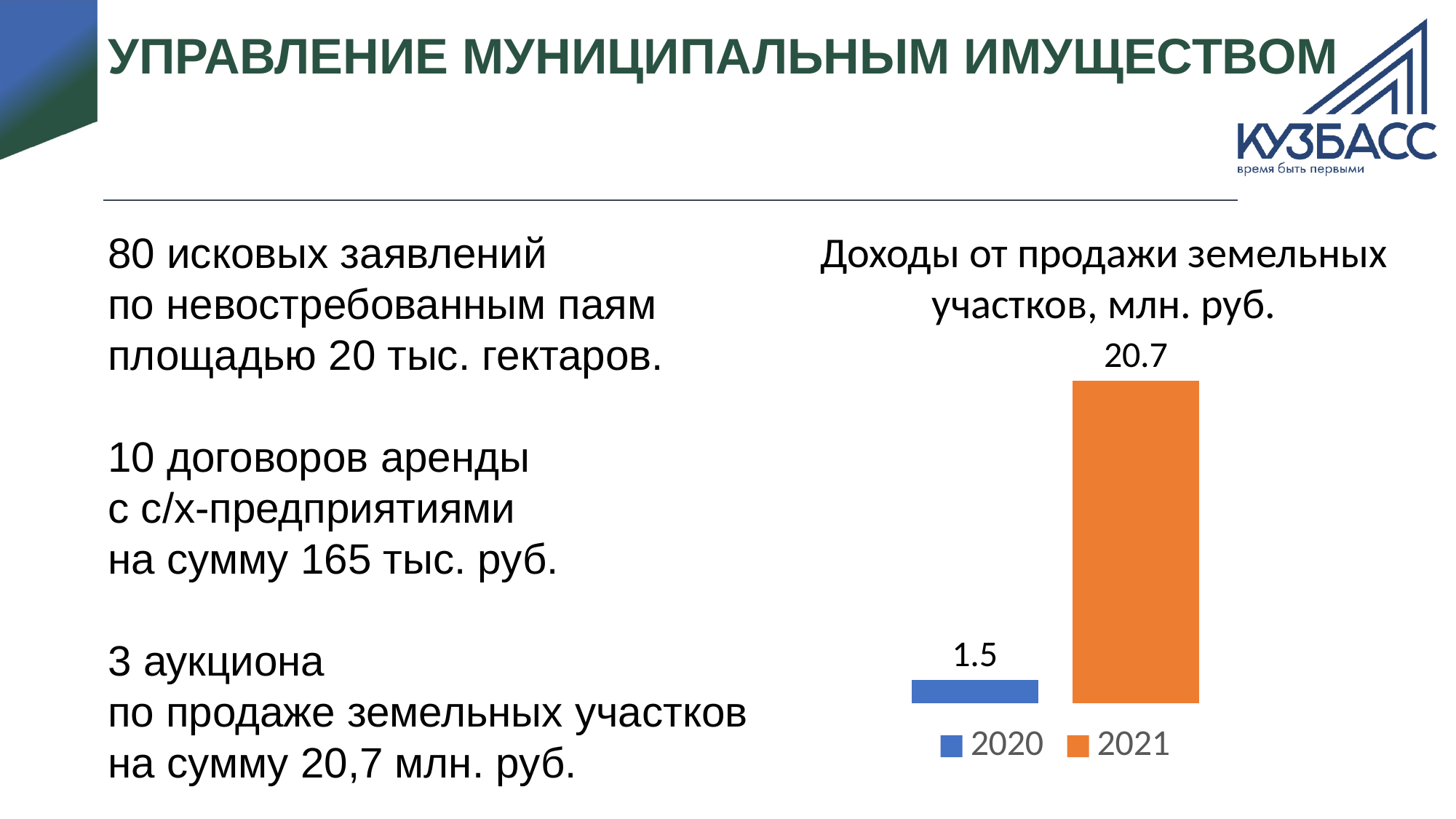
Do the values rise or fall from 2020 to 2021 in the chart? rise What is the value for 2021 in the chart 'Доходы от продажи земельных участков, млн. руб.'? 20.7 How many entries does the chart legend list? 2 What colour is the bar for 2021 in the chart? orange What is the difference between the 2021 and 2020 values in the chart? 19.2 Which year has the highest value in the chart? 2021 What is the value for 2020 in the chart 'Доходы от продажи земельных участков, млн. руб.'? 1.5 How many bars are plotted in the chart? 2 What is the title of the chart on the slide? Доходы от продажи земельных участков, млн. руб. What kind of chart is shown on the slide? bar chart Which year has the lowest value in the chart? 2020 Which is larger in the chart: the value for 2020 or the value for 2021? 2021